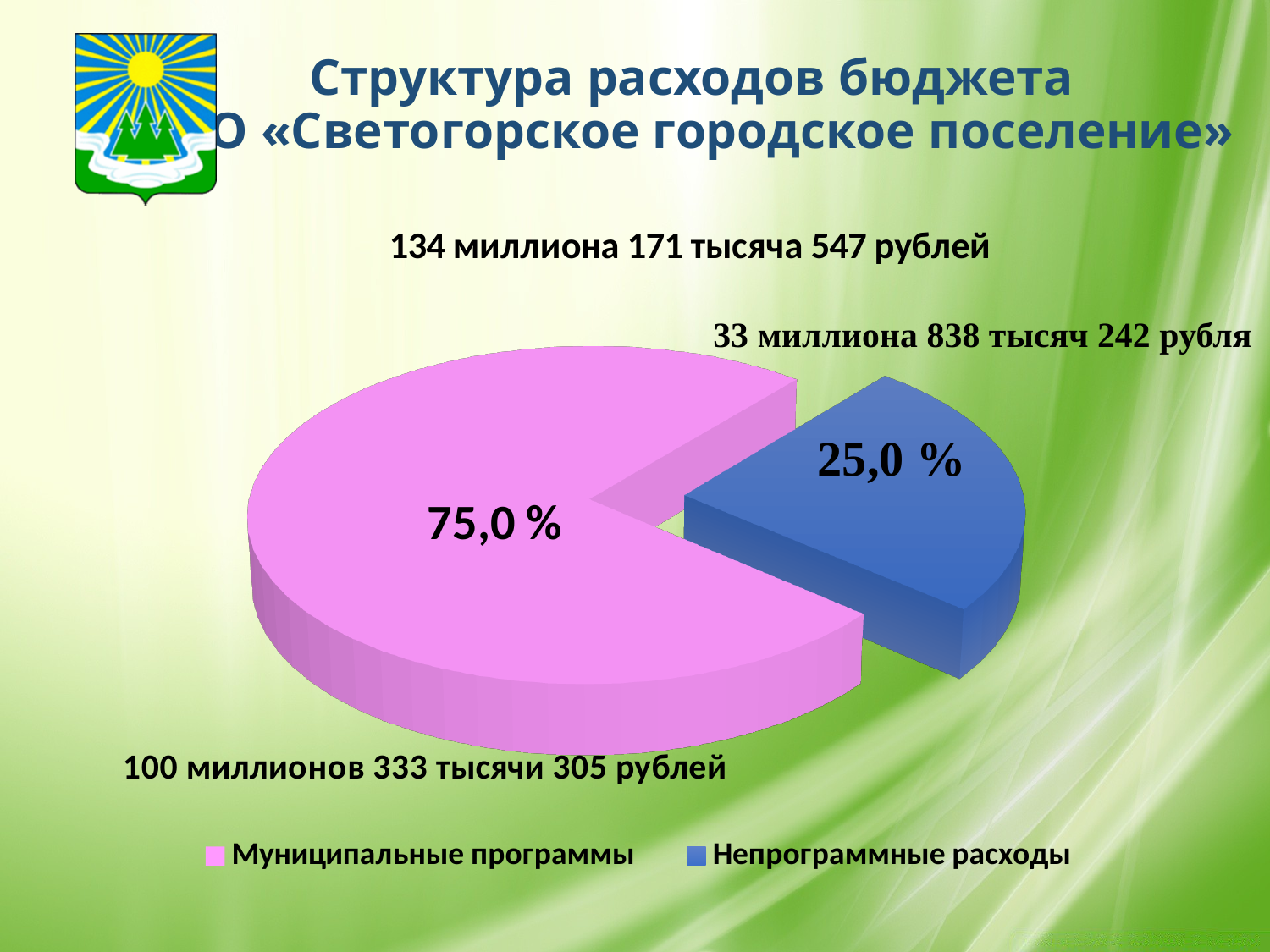
What amount in rubles is labelled for Муниципальные программы? 100 миллионов 333 тысячи 305 рублей What share of the pie does the slice for Муниципальные программы represent? 75,0 % How many slices does the pie chart have? 2 What amount in rubles is labelled for Непрограммные расходы? 33 миллиона 838 тысяч 242 рубля Which category has the smallest slice of the pie? Непрограммные расходы What kind of chart is shown on the slide? Pie chart What is the difference in percentage points between the share for Муниципальные программы and the share for Непрограммные расходы? 50,0 % What colour is the slice for Непрограммные расходы? Blue Which category has the largest slice of the pie? Муниципальные программы What share of the pie does the slice for Непрограммные расходы represent? 25,0 % Which is larger: the share for Муниципальные программы or the share for Непрограммные расходы? Муниципальные программы What total amount is shown above the pie chart? 134 миллиона 171 тысяча 547 рублей